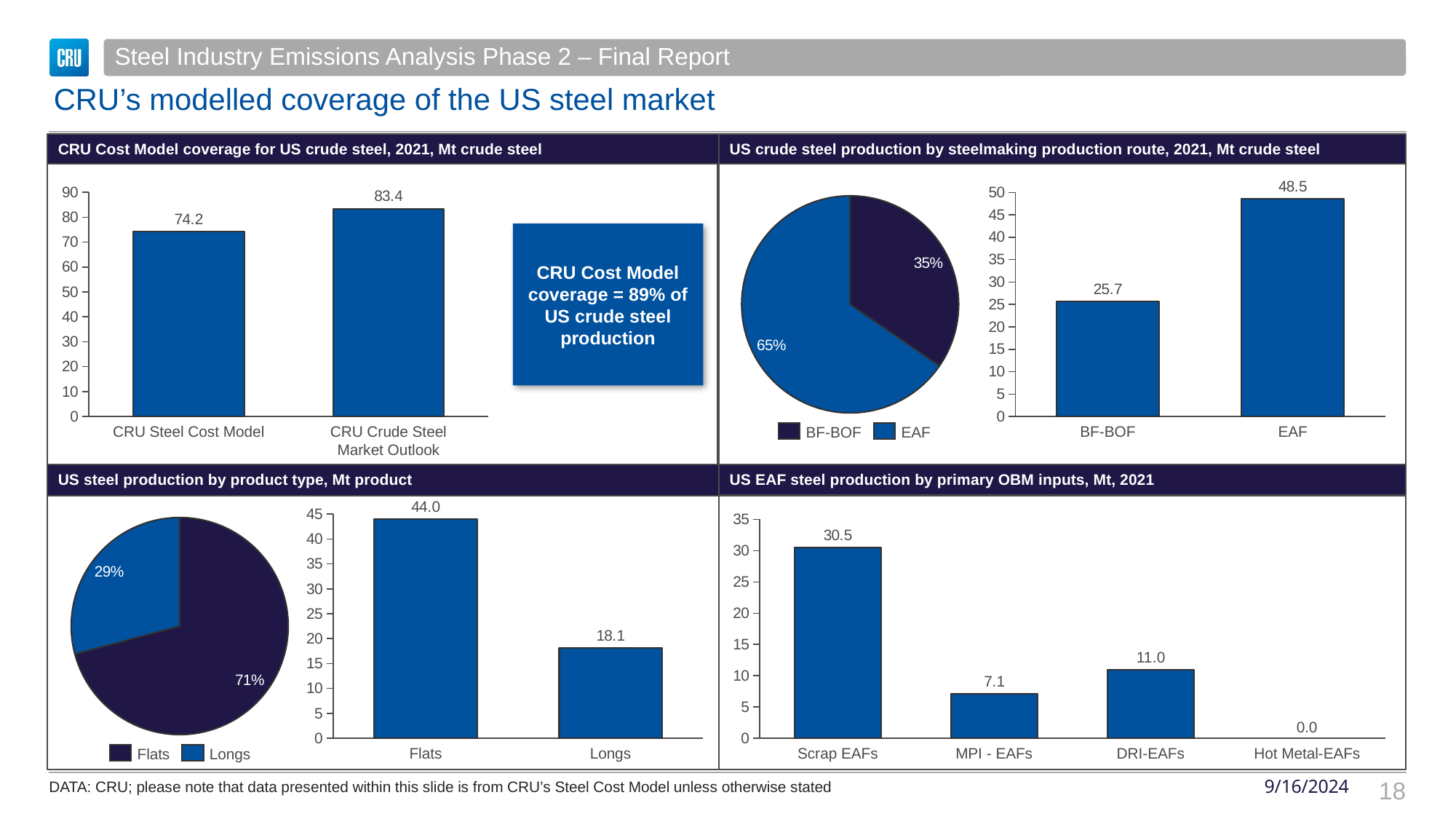
In the 'US crude steel production by steelmaking production route, 2021, Mt crude steel' chart, what share of the pie does BF-BOF represent? 35% In the 'CRU Cost Model coverage for US crude steel, 2021, Mt crude steel' chart, what is the value for CRU Steel Cost Model? 74.2 In the 'US EAF steel production by primary OBM inputs, Mt, 2021' chart, which category has the highest value? Scrap EAFs In the 'US crude steel production by steelmaking production route, 2021, Mt crude steel' bar chart, what is the value for EAF? 48.5 In the 'US EAF steel production by primary OBM inputs, Mt, 2021' chart, which category has the lowest value? Hot Metal-EAFs In the 'US steel production by product type, Mt product' chart, what is the value for Longs? 18.1 In the 'US EAF steel production by primary OBM inputs, Mt, 2021' chart, how many categories are shown? 4 In the 'CRU Cost Model coverage for US crude steel, 2021, Mt crude steel' chart, what is the difference between CRU Crude Steel Market Outlook and CRU Steel Cost Model? 9.2 In the 'US EAF steel production by primary OBM inputs, Mt, 2021' chart, what is the difference between DRI-EAFs and MPI - EAFs? 3.9 In the 'US crude steel production by steelmaking production route, 2021, Mt crude steel' chart, which is larger, BF-BOF or EAF? EAF What kind of chart is the 'US EAF steel production by primary OBM inputs, Mt, 2021' chart? Bar chart In the 'US steel production by product type, Mt product' chart, what share of the pie do Flats represent? 71%